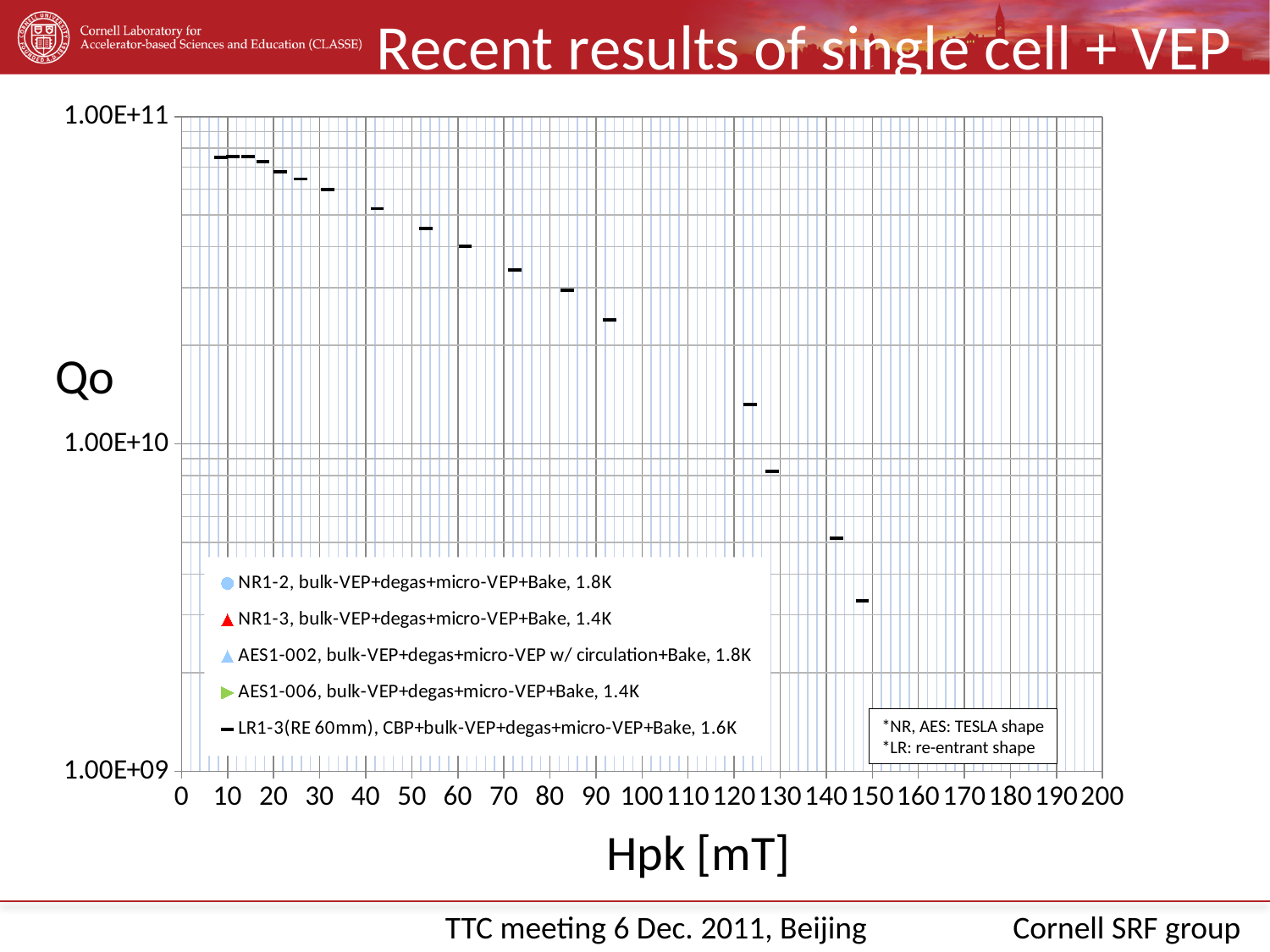
What is the label of the y axis of the chart? Qo How many series does the chart legend list? 5 Is the Qo value of the plotted LR1-3 data at Hpk around 90 mT greater or less than 1.00E+10? greater Is the Qo value of the plotted LR1-3 data at Hpk around 130 mT greater or less than 1.00E+10? less What is the label of the x axis of the chart? Hpk [mT] What is the highest value shown on the y axis of the chart? 1.00E+11 Which is larger, the Qo value of the plotted data at Hpk around 40 mT or at Hpk around 140 mT? Hpk around 40 mT What kind of chart is shown on the slide? scatter chart Do the plotted Qo values rise or fall as Hpk increases? fall Is the Qo value of the plotted LR1-3 data at Hpk around 10 mT greater or less than 1.00E+10? greater